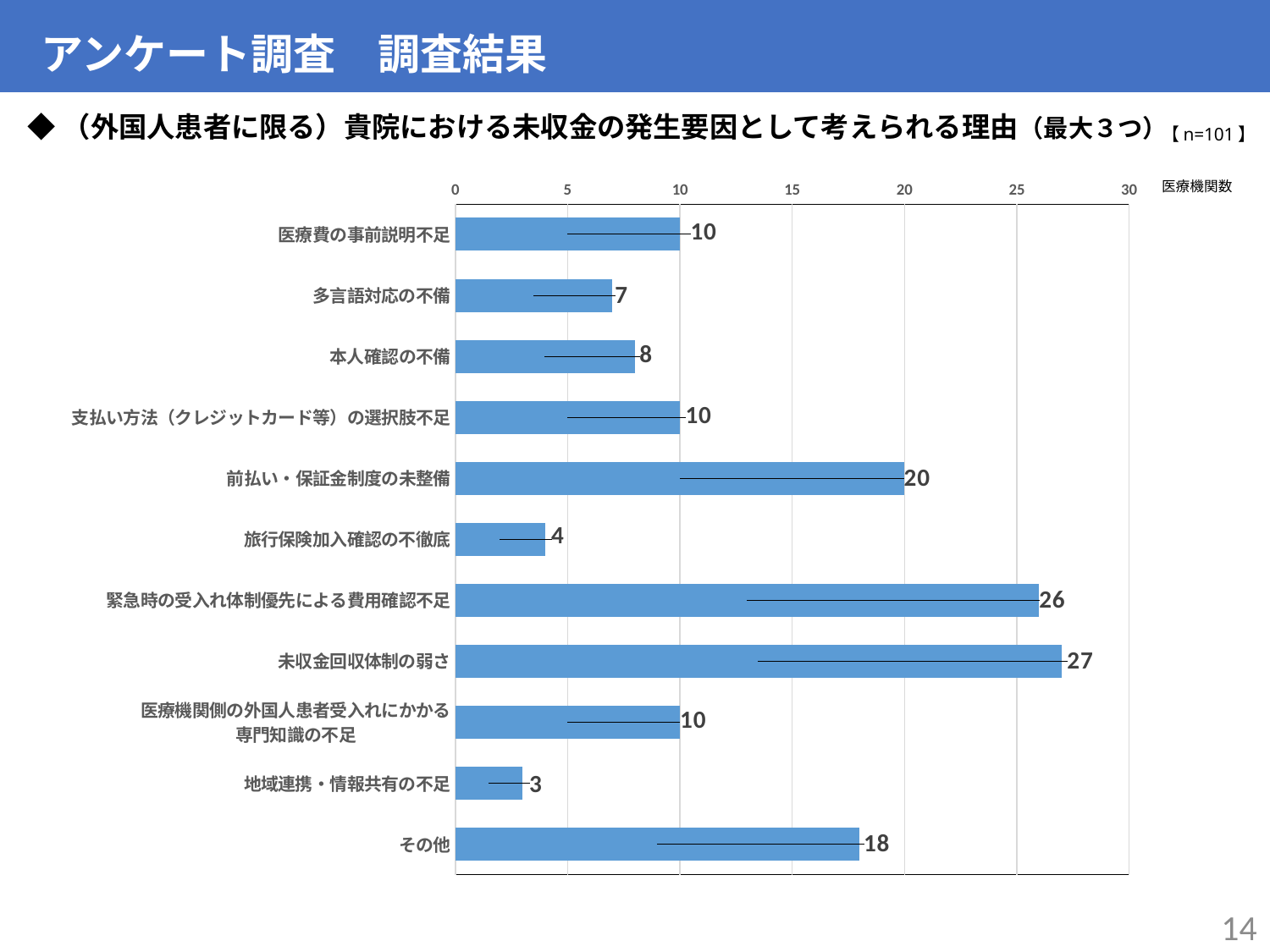
Which is larger, the value for 多言語対応の不備 or the value for 本人確認の不備? 本人確認の不備 What is the value for 緊急時の受入れ体制優先による費用確認不足? 26 What is the difference between the values for 未収金回収体制の弱さ and 前払い・保証金制度の未整備? 7 What is the value for その他? 18 What is the value for 旅行保険加入確認の不徹底? 4 What kind of chart is shown on the slide? Bar chart Which category has the highest value? 未収金回収体制の弱さ What is the value for 前払い・保証金制度の未整備? 20 How many categories are shown in the chart? 11 What is the sample size (n) shown on the slide? n=101 What is the label of the horizontal axis unit shown at the top right of the chart? 医療機関数 Which category has the lowest value? 地域連携・情報共有の不足